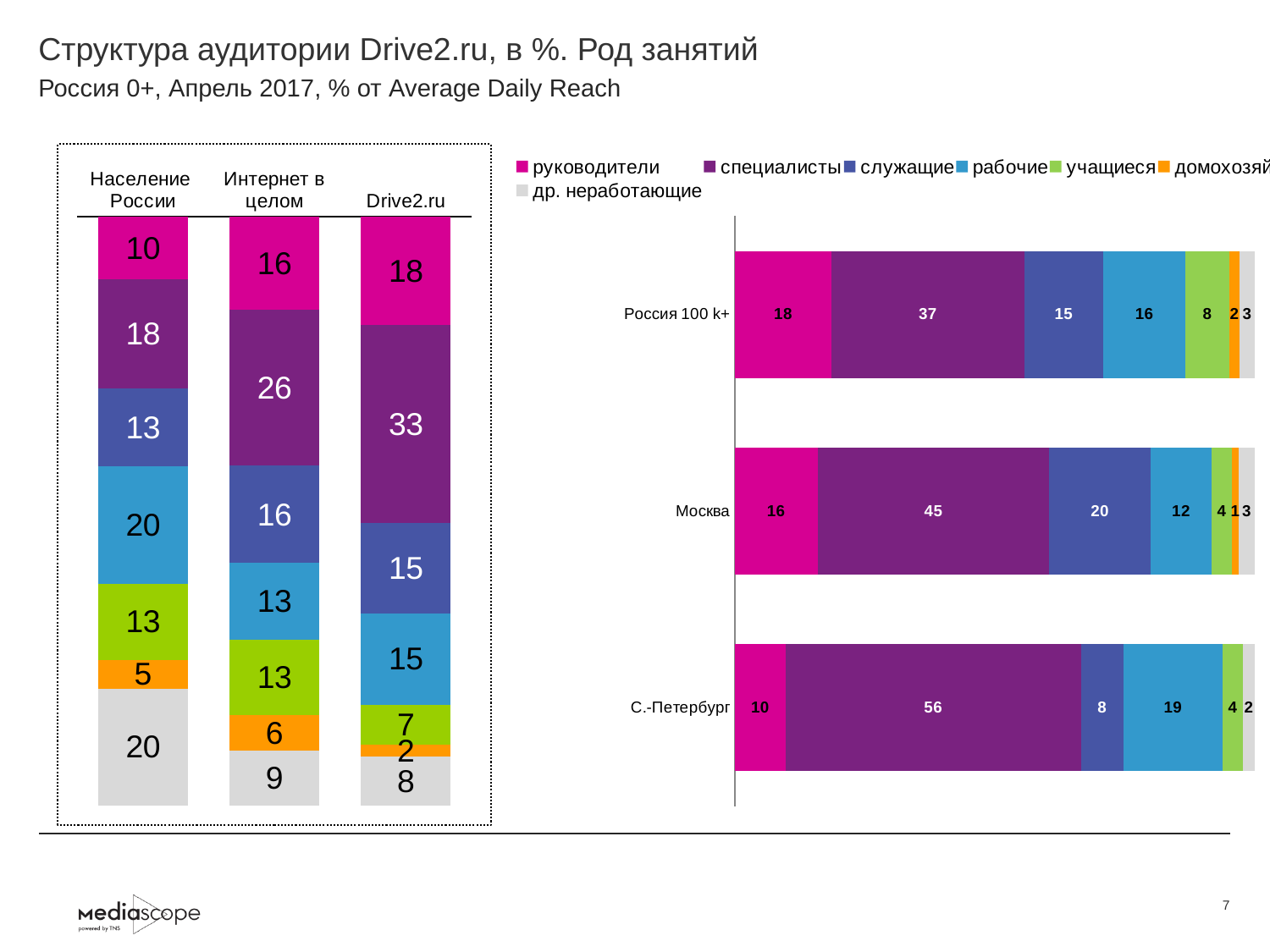
What kind of chart is the right chart? Stacked bar chart How many series does the legend list? 7 In the left chart, what is the value for рабочие in the Население России bar? 20 In the left chart, what is the difference between the специалисты values for Drive2.ru and Население России? 15 In the right chart, what is the value for служащие for Москва? 20 How many bars does the right chart show? 3 In the right chart, which region has the highest value for специалисты? С.-Петербург In the left chart, what is the value for специалисты in the Drive2.ru bar? 33 In the left chart, which bar has the lowest value for руководители? Население России In the left chart, what is the total of the Интернет в целом bar? 99 In the right chart, what is the value for специалисты for С.-Петербург? 56 In the right chart, which is larger: the рабочие value for С.-Петербург or for Москва? С.-Петербург